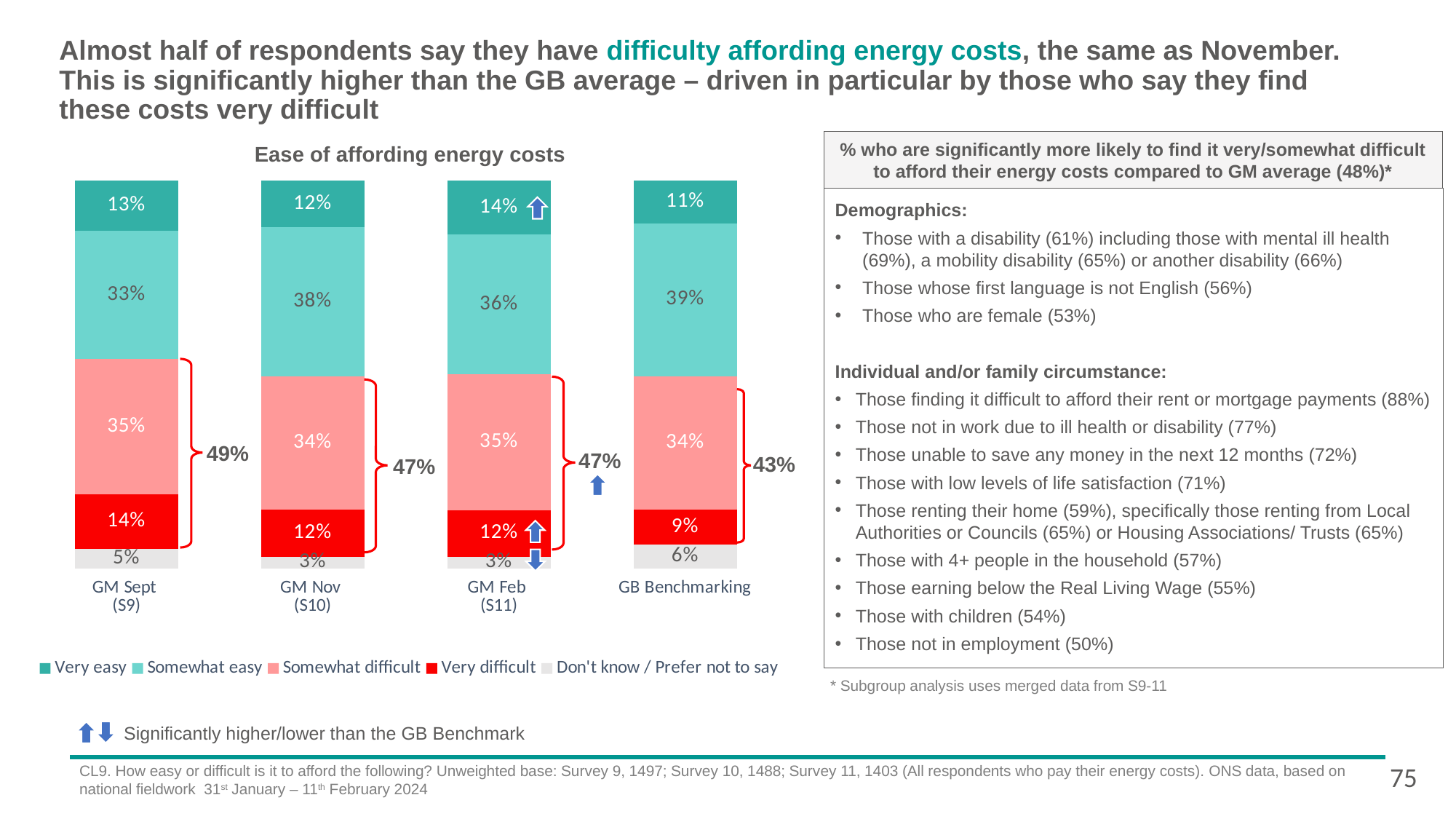
What percentage of GM Sept (S9) respondents said it was very difficult to afford energy costs? 14% How many series does the legend list? 5 How many percentage points higher is the 'Somewhat easy' value for GM Nov (S10) than for GM Sept (S9)? 5 percentage points What type of chart is used to show ease of affording energy costs? Stacked bar chart Which has the larger 'Very easy' value, GM Sept (S9) or GB Benchmarking? GM Sept (S9) What is the 'Very easy' value for GM Feb (S11)? 14% What is the 'Somewhat easy' value for GB Benchmarking? 39% What is the 'Don't know / Prefer not to say' value for GB Benchmarking? 6% How many categories (bars) are shown in the chart? 4 What is the combined 'Somewhat difficult' and 'Very difficult' share for GM Sept (S9)? 49% Which category has the lowest 'Very difficult' value? GB Benchmarking Which category has the highest 'Somewhat easy' value? GB Benchmarking